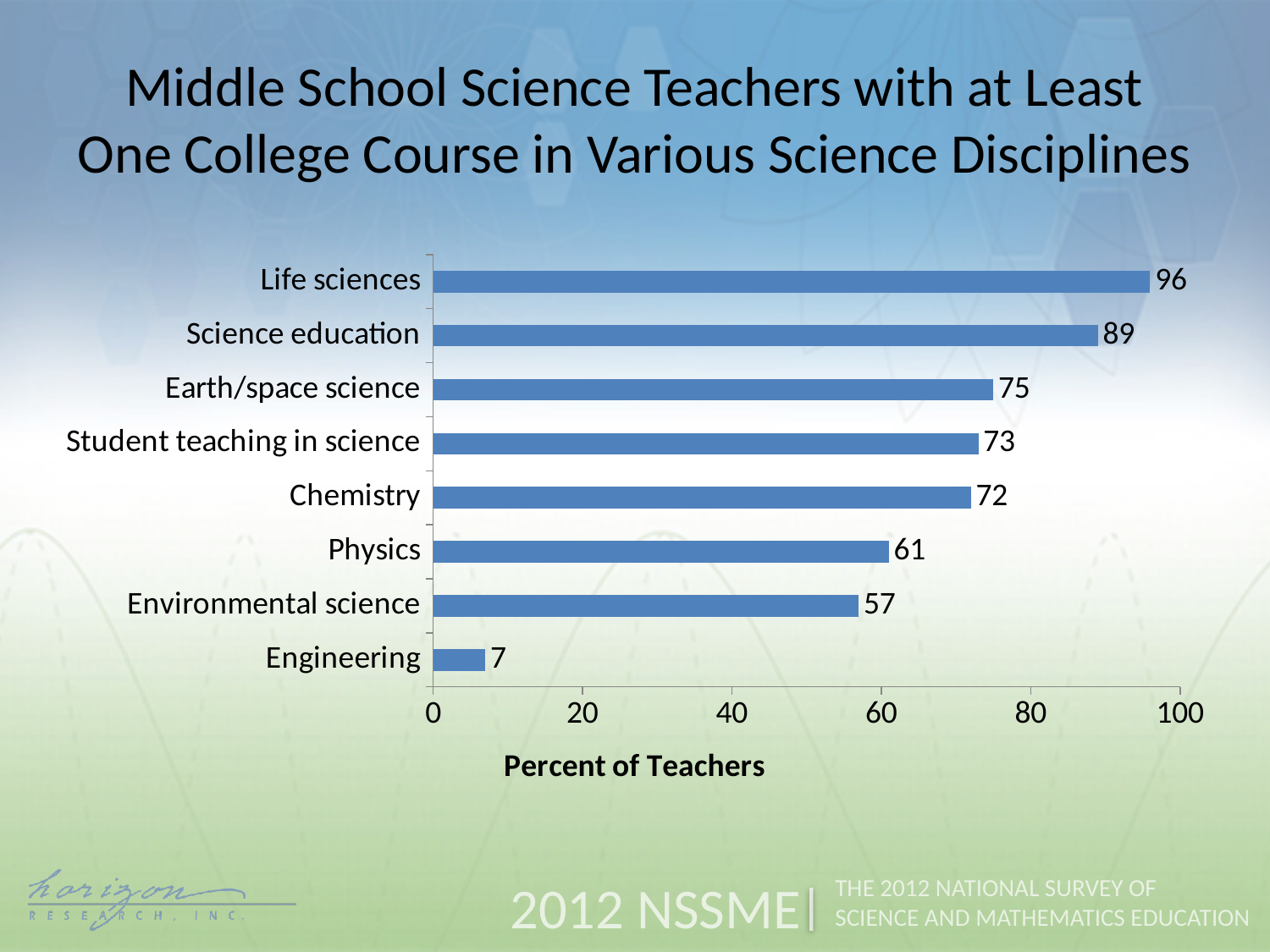
Which discipline has the lowest percent of teachers? Engineering Which discipline has the highest percent of teachers? Life sciences What is the label on the horizontal axis of the chart? Percent of Teachers How many disciplines are shown in the chart? 8 What is the value shown for Chemistry? 72 What is the difference between the values for Earth/space science and Environmental science? 18 What kind of chart is shown on the slide? Bar chart What is the value shown for Engineering? 7 What percent of middle school science teachers have at least one college course in Life sciences? 96 Is the value for Student teaching in science greater or less than 60? greater What is the difference between the values for Science education and Physics? 28 Which is larger, the value for Physics or the value for Environmental science? Physics